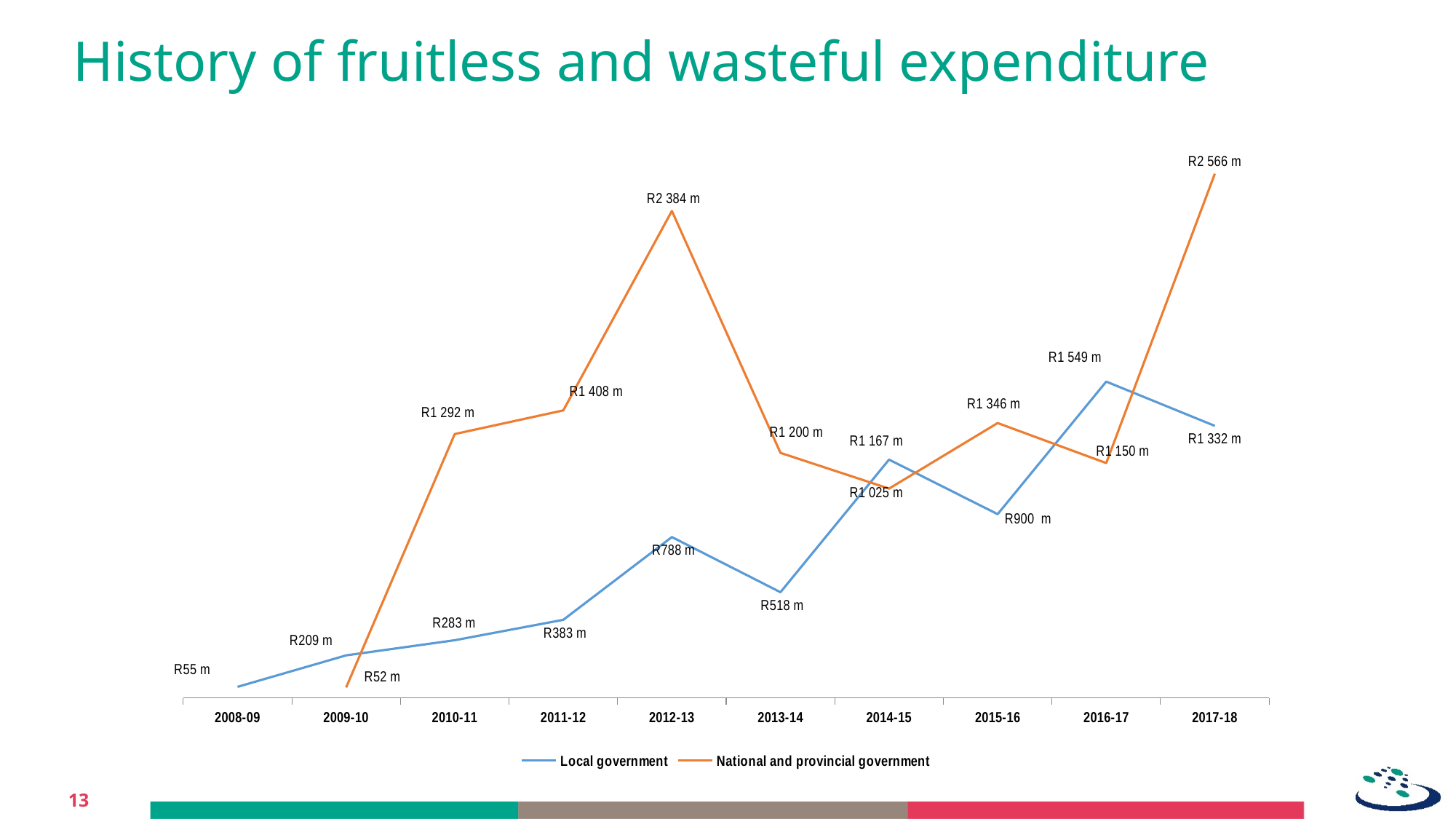
What kind of chart is shown on the slide? Line chart What is the title of the slide? History of fruitless and wasteful expenditure What is the difference between National and provincial government and Local government in 2017-18? R1 234 m What is the value for National and provincial government in 2017-18? R2 566 m How many financial years are shown on the x axis? 10 In which year is the Local government value lowest? 2008-09 How many series does the legend list? 2 In which year is the National and provincial government value highest? 2017-18 What is the value for Local government in 2012-13? R788 m In 2014-15, which series has the larger value, Local government or National and provincial government? Local government Does the National and provincial government value rise or fall from 2012-13 to 2014-15? Fall In which year is the Local government value highest? 2016-17